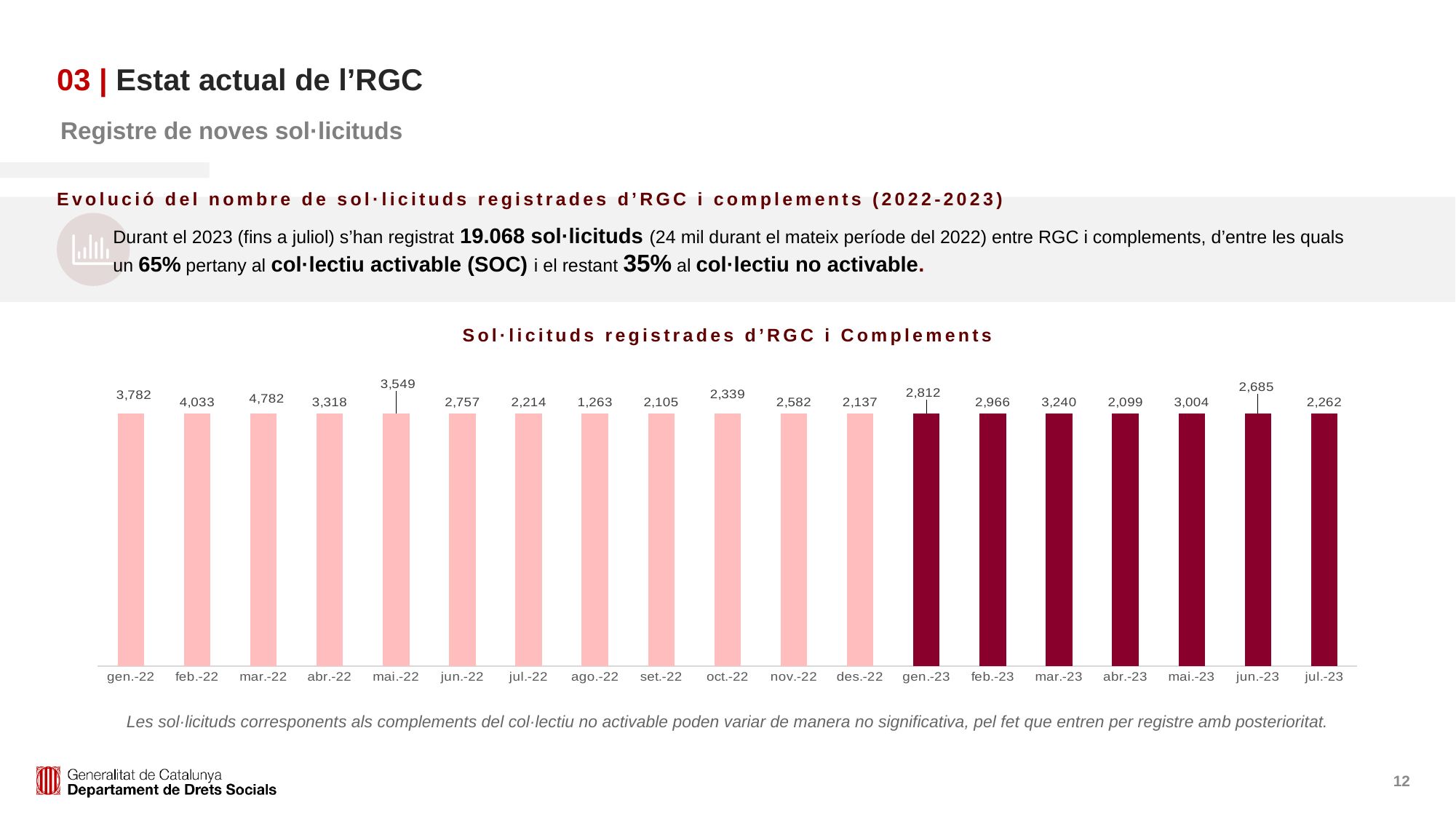
What is the title of the chart? Sol·licituds registrades d'RGC i Complements What kind of chart is shown on the slide? Bar chart What is the difference between the values for mar.-22 and ago.-22? 3,519 Which month has the highest value in the chart? mar.-22 Which month has the lowest value in the chart? ago.-22 What is the value for mar.-22 in the chart? 4,782 What is the value for mar.-23 in the chart? 3,240 What is the value for ago.-22 in the chart? 1,263 What is the value for jul.-23 in the chart? 2,262 What is the difference between the values for mar.-22 and mar.-23? 1,542 How many months are shown on the x axis of the chart? 19 Which is larger, the value for feb.-22 or the value for feb.-23? feb.-22